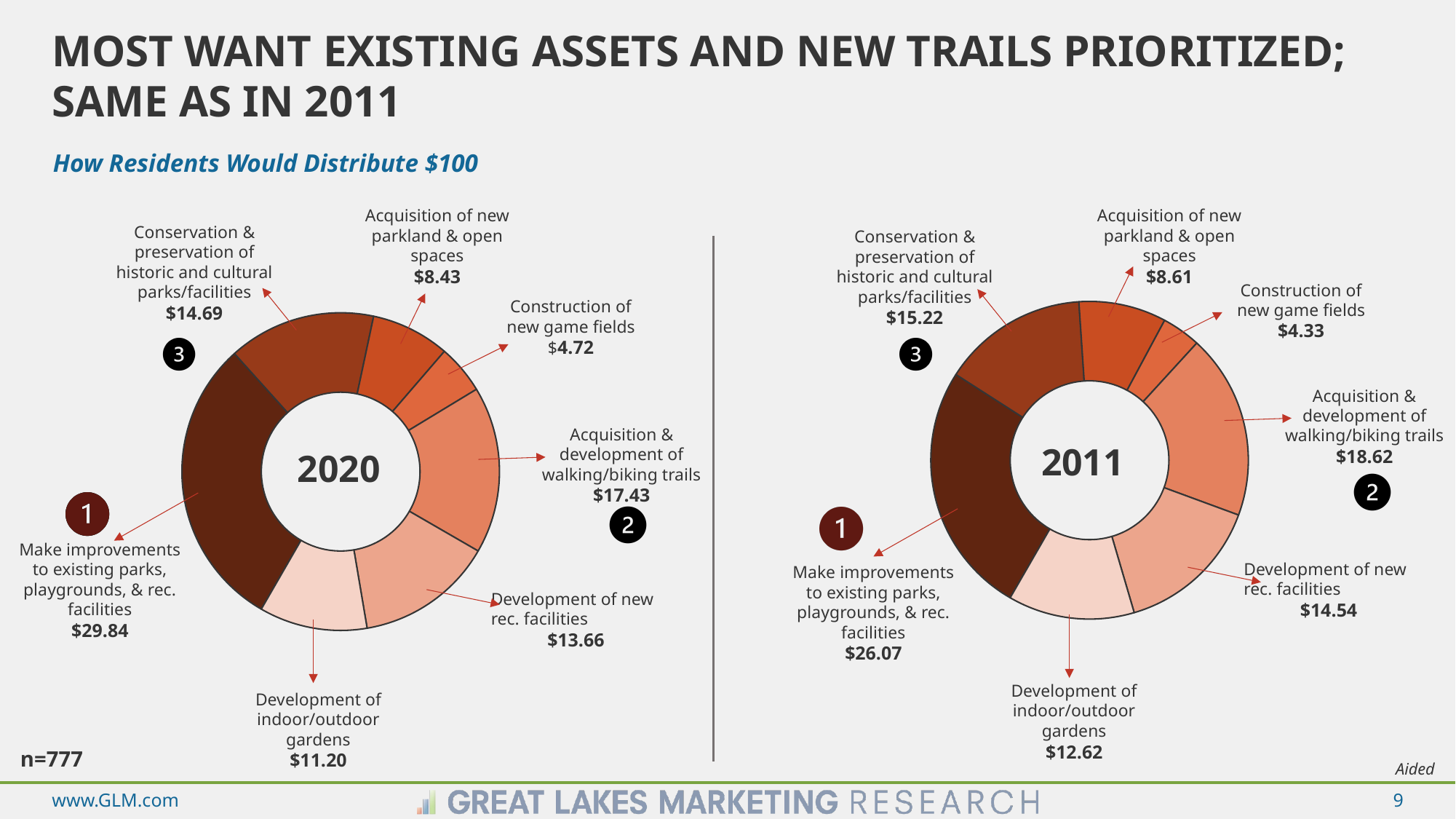
What is the sample size (n) shown on the slide? n=777 In the 2020 chart, what is the difference between acquisition & development of walking/biking trails and development of new rec. facilities? $3.77 In the 2020 chart, what is the value for development of indoor/outdoor gardens? $11.20 What type of chart is used to show how residents would distribute $100? Donut (pie) chart How many categories are shown in the 2020 chart? 7 In the 2020 chart, how much would residents allocate to making improvements to existing parks, playgrounds, & rec. facilities? $29.84 Which is larger: the 2020 allocation for acquisition of new parkland & open spaces or the 2011 allocation for the same category? 2011 In the 2020 chart, which category receives the largest allocation? Make improvements to existing parks, playgrounds, & rec. facilities What is the difference between the 2020 and 2011 allocations for making improvements to existing parks, playgrounds, & rec. facilities? $3.77 In the 2011 chart, how much would residents allocate to acquisition & development of walking/biking trails? $18.62 In the 2011 chart, what is the value for conservation & preservation of historic and cultural parks/facilities? $15.22 In the 2011 chart, which category receives the smallest allocation? Construction of new game fields